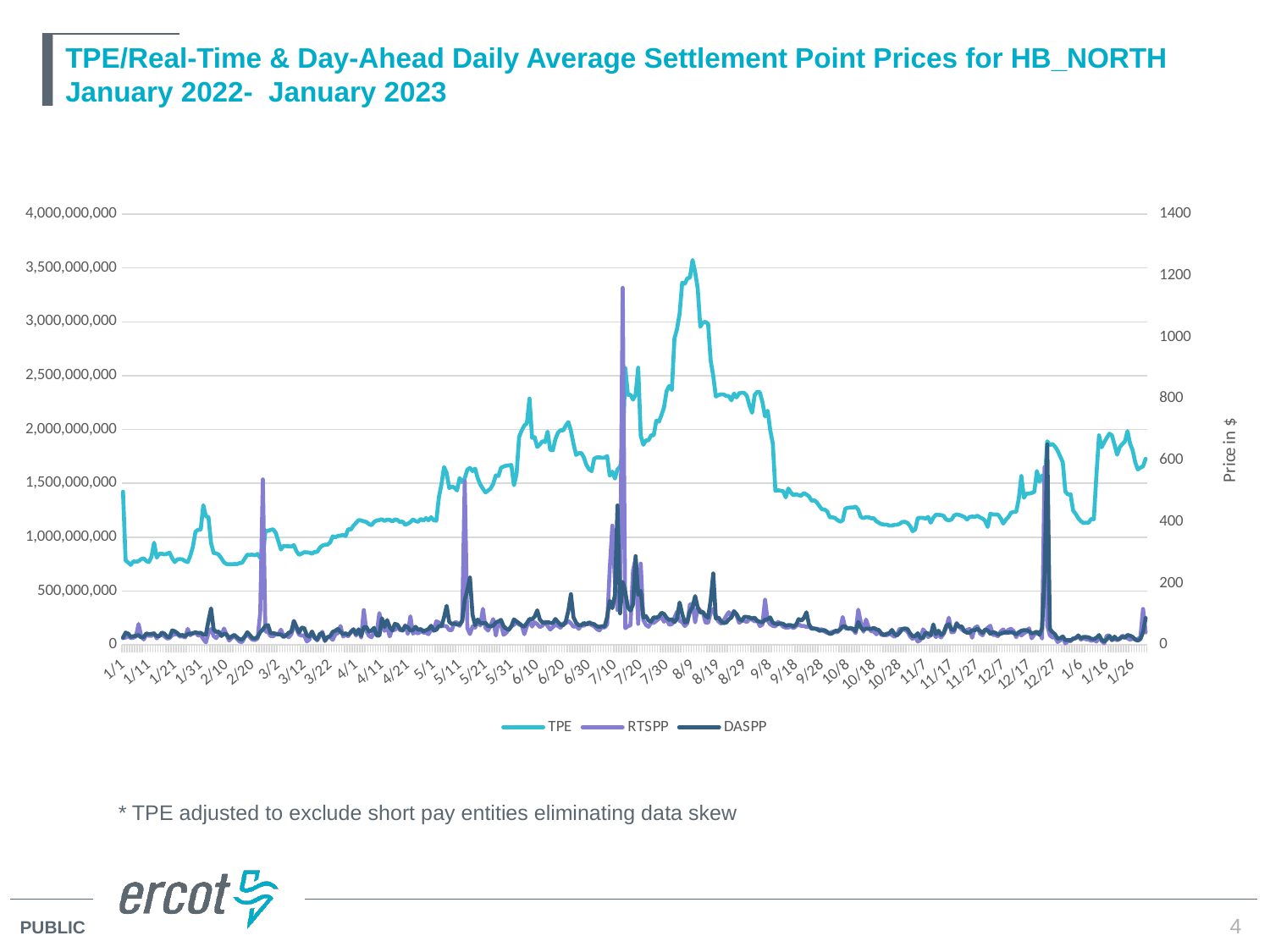
How many series does the legend list? 3 What are the three series named in the legend? TPE, RTSPP, DASPP Does the TPE line rise or fall between 8/9 and 9/18? fall Is the peak value of the TPE line (around 8/9) greater or less than 3,000,000,000 on the left axis? greater Does the TPE line generally rise or fall between 3/22 and 6/10? rise Is the TPE value around 10/28 greater or less than 1,500,000,000 on the left axis? less Is the spike of the DASPP line around 12/27 greater or less than 400 on the right axis? greater What is the title of the right-hand vertical axis? Price in $ Which series reaches a higher peak on the right-hand price axis, RTSPP or DASPP? RTSPP What kind of chart is shown on the slide? line chart